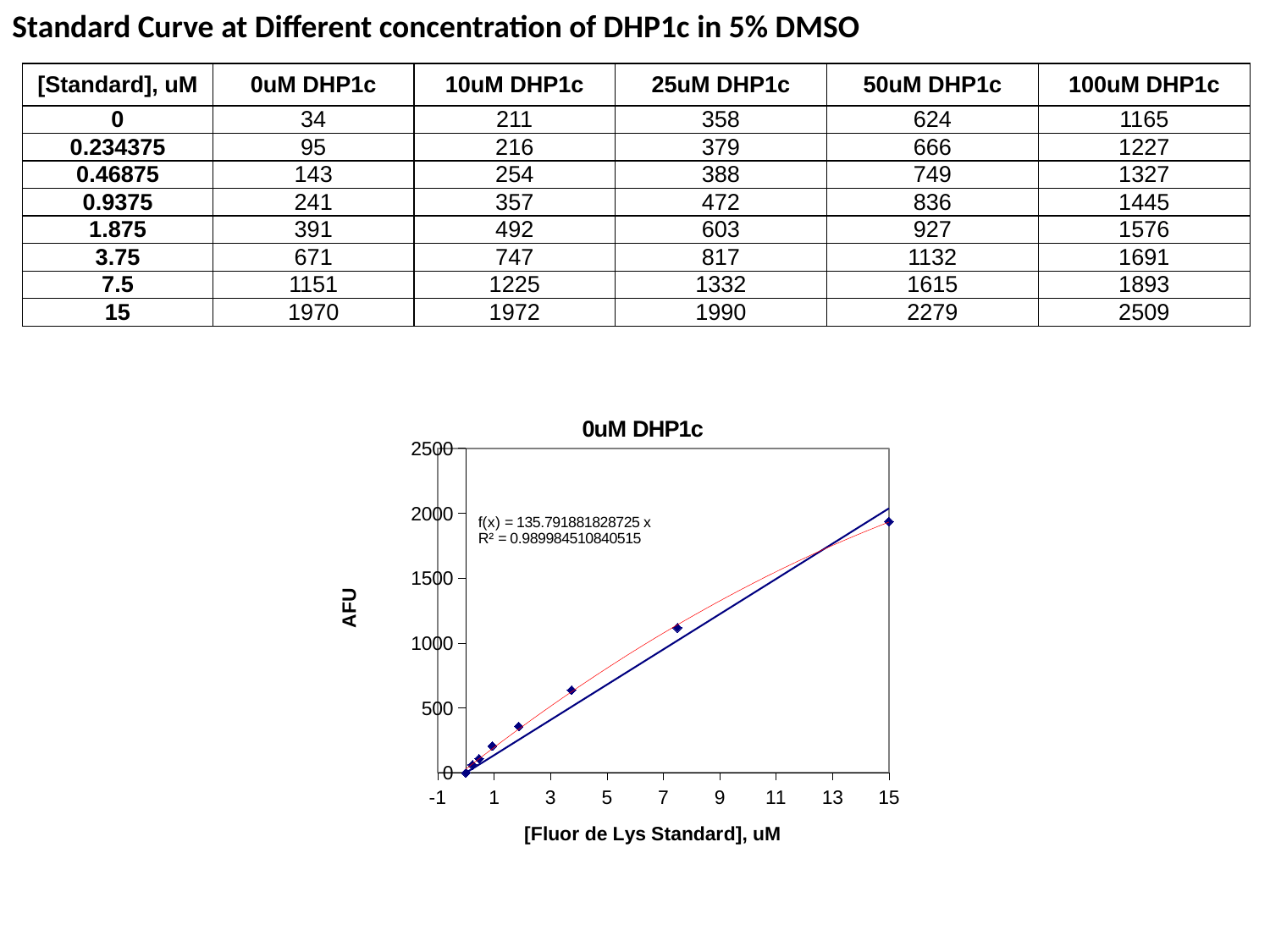
Is the AFU value at 3.75 uM standard greater or less than 1000? less At which standard concentration is the AFU value lowest in the chart? 0 Is the AFU value at 15 uM standard greater or less than 1500? greater What is the y-axis title of the chart? AFU How many data points are plotted in the chart? 8 What is the R² value shown on the chart's trendline? 0.989984510840515 Using the table values for 0uM DHP1c, what is the difference in AFU between the 15 uM and 0 uM standard concentrations? 1936 What is the title of the chart? 0uM DHP1c At which standard concentration is the AFU value highest in the chart? 15 According to the table, what is the AFU value for 0uM DHP1c at a standard concentration of 3.75 uM? 671 Do the AFU values rise or fall as the standard concentration increases along the x axis? rise What kind of chart is shown on the slide? scatter chart